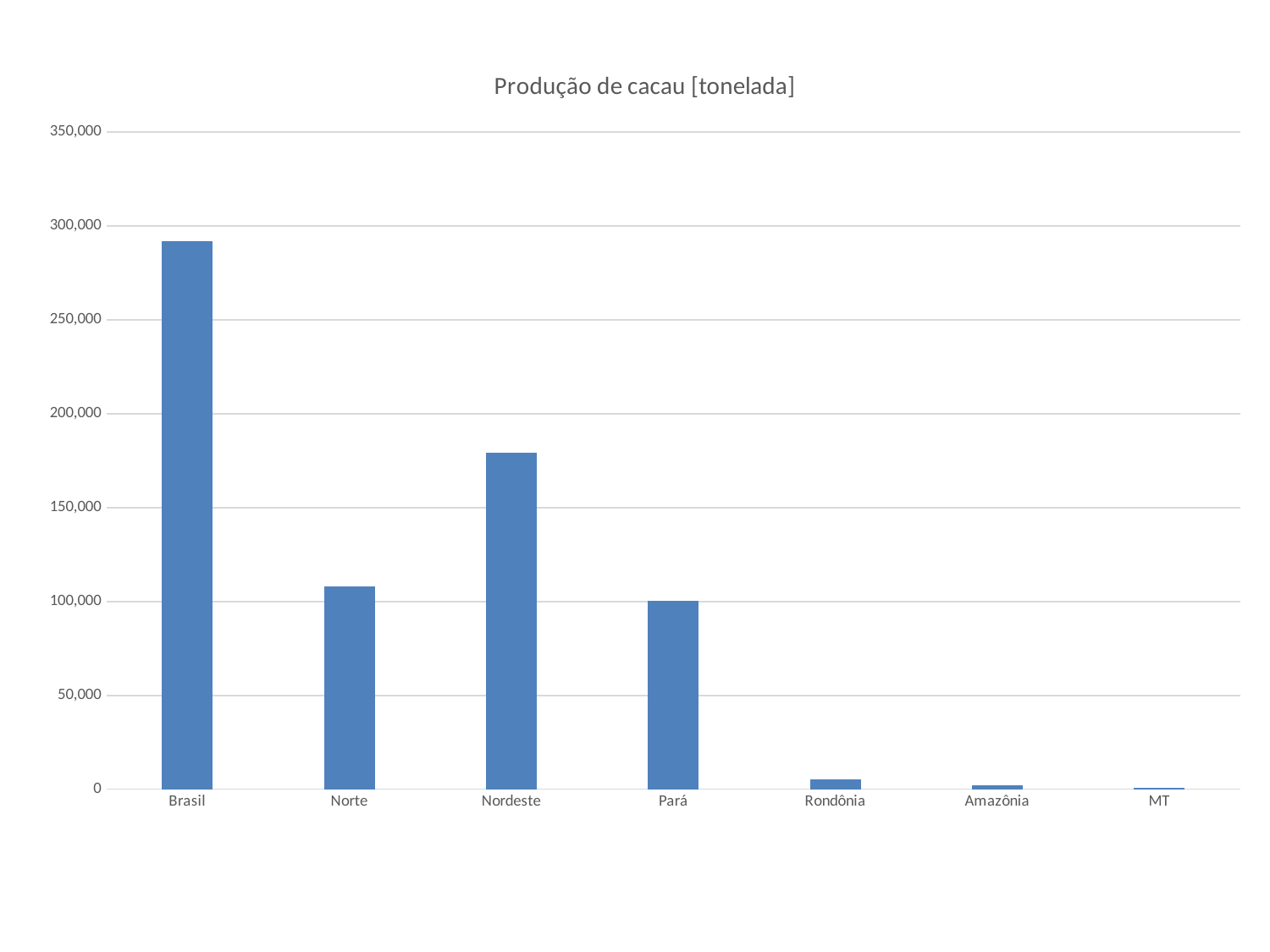
What type of chart is shown on the slide? bar chart Which is larger, the value for Rondônia or the value for Amazônia? Rondônia Which is larger, the value for Nordeste or the value for Norte? Nordeste Is the value for Norte greater or less than 150,000? less Is the value for Rondônia greater or less than 50,000? less Which category has the highest cocoa production? Brasil Is the value for Brasil greater or less than 250,000? greater How many categories are shown on the x axis? 7 What is the title of the chart? Produção de cacau [tonelada] Which is larger, the value for Norte or the value for Pará? Norte